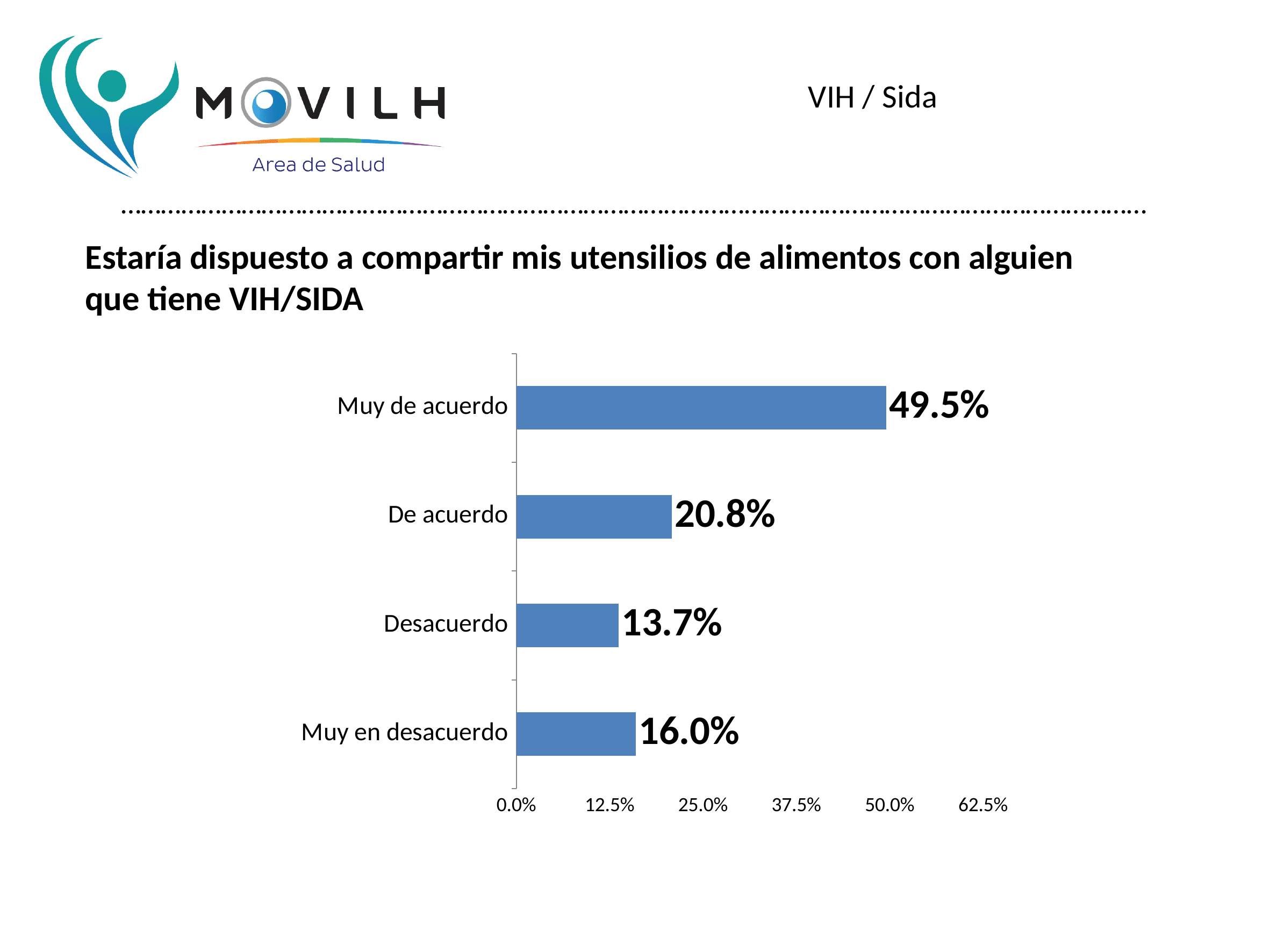
How many categories are shown in the chart? 4 What kind of chart is shown on the slide? Bar chart Is the value for "Muy de acuerdo" greater or less than 37.5%? greater What is the value for "Desacuerdo"? 13.7% Which category has the lowest value? Desacuerdo Which category has the highest value? Muy de acuerdo Which is larger, the value for "De acuerdo" or the value for "Muy en desacuerdo"? De acuerdo What is the difference between the values for "Muy en desacuerdo" and "Desacuerdo"? 2.3% What is the value for "Muy en desacuerdo"? 16.0% What is the value for "De acuerdo"? 20.8% What is the value for "Muy de acuerdo"? 49.5% What is the difference between the values for "Muy de acuerdo" and "De acuerdo"? 28.7%